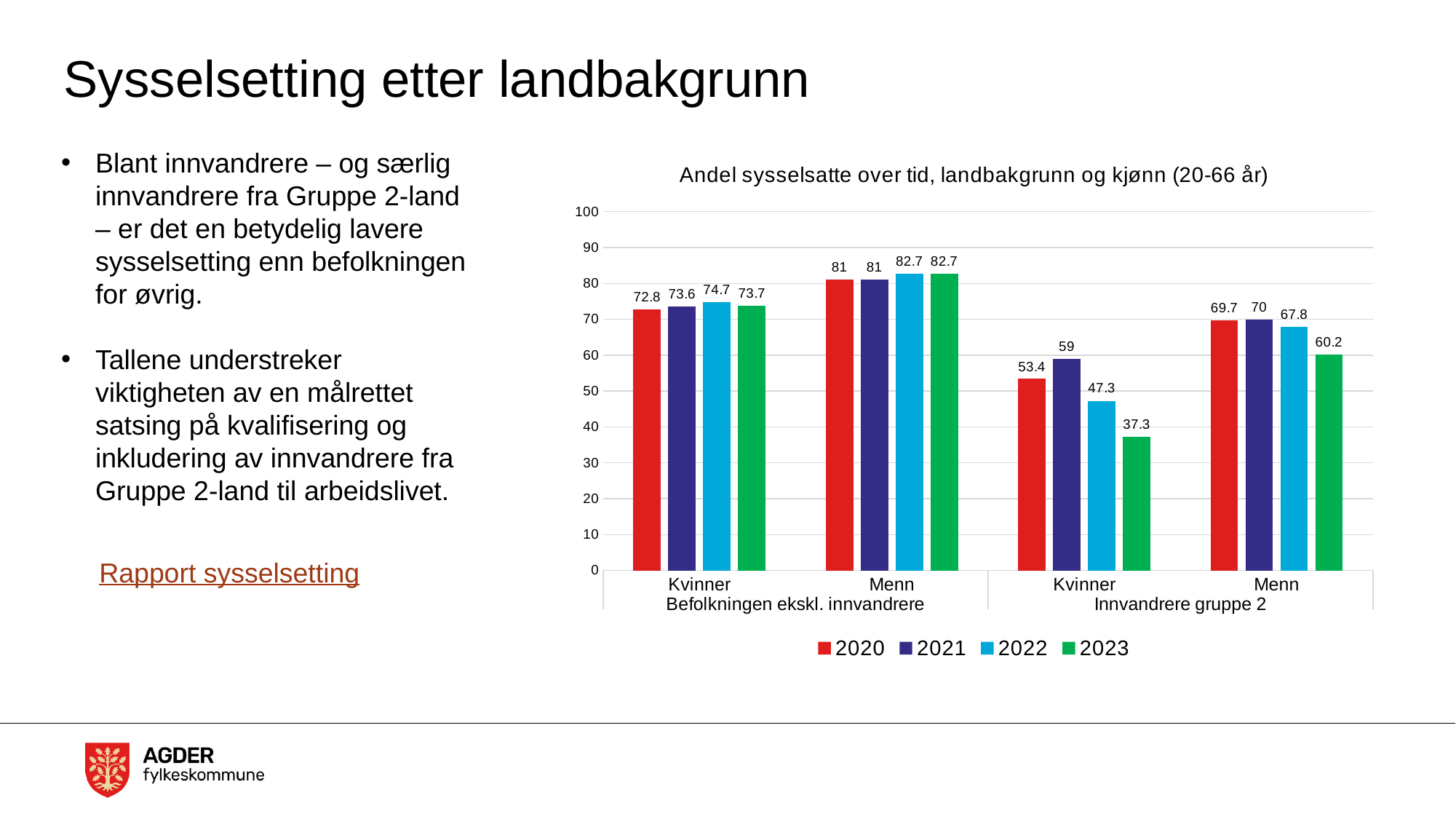
How many series does the legend list? 4 What is the value for Menn in Innvandrere gruppe 2 for 2023? 60.2 Which category has the highest value for 2022? Menn, Befolkningen ekskl. innvandrere What is the value for Kvinner in Innvandrere gruppe 2 for 2021? 59 Do the values for Kvinner in Innvandrere gruppe 2 rise or fall from 2021 to 2023? fall What is the title of the chart? Andel sysselsatte over tid, landbakgrunn og kjønn (20-66 år) What is the value for Kvinner in Befolkningen ekskl. innvandrere for 2020? 72.8 Which category has the lowest value for 2023? Kvinner, Innvandrere gruppe 2 What kind of chart is shown on the slide? bar chart Which is larger for Menn in Innvandrere gruppe 2: the 2021 value or the 2022 value? 2021 Is the 2023 value for Kvinner in Innvandrere gruppe 2 greater or less than 40? less What is the difference between the 2020 and 2023 values for Kvinner in Innvandrere gruppe 2? 16.1